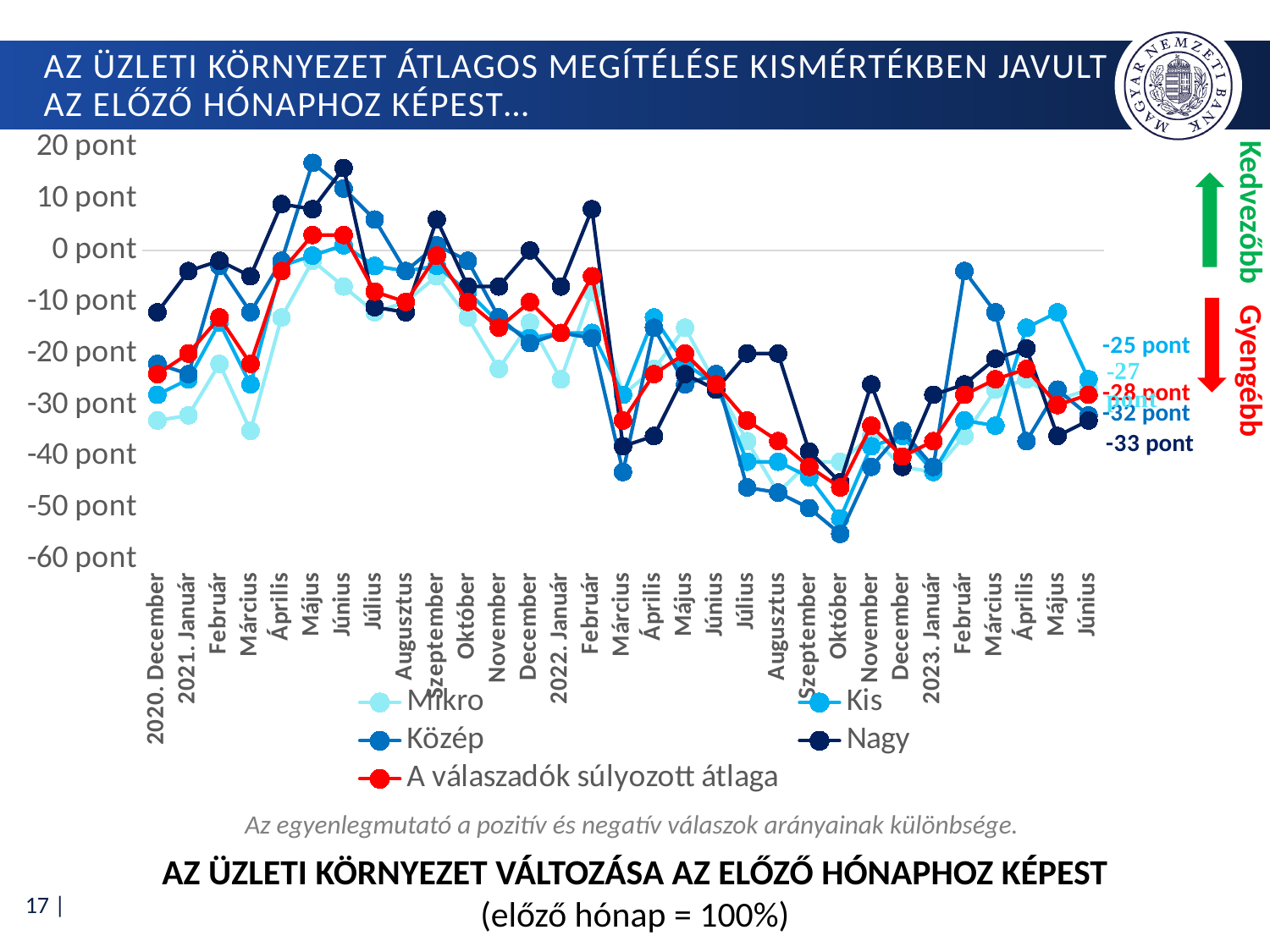
What is the value of the 'Kis' series at the last point (2023. Június)? -25 pont Which series has the lowest value at the last point (2023. Június)? Nagy What is the value of 'A válaszadók súlyozott átlaga' at the last point (2023. Június)? -28 pont Is the value of 'Közép' in 2022. Október greater or less than -50 pont? less How many series does the legend list? 5 At the last point (2023. Június), which is higher: 'Kis' or 'Nagy'? Kis What is the value of the 'Közép' series at the last point (2023. Június)? -32 pont What is the value of the 'Nagy' series at the last point (2023. Június)? -33 pont Is the value of 'Közép' in 2021. Május greater or less than 10 pont? greater What kind of chart is shown on the slide? line chart How many months (data points) are shown on the x axis? 31 What is the difference between the 'Kis' and 'Nagy' values at the last point (2023. Június)? 8 pont